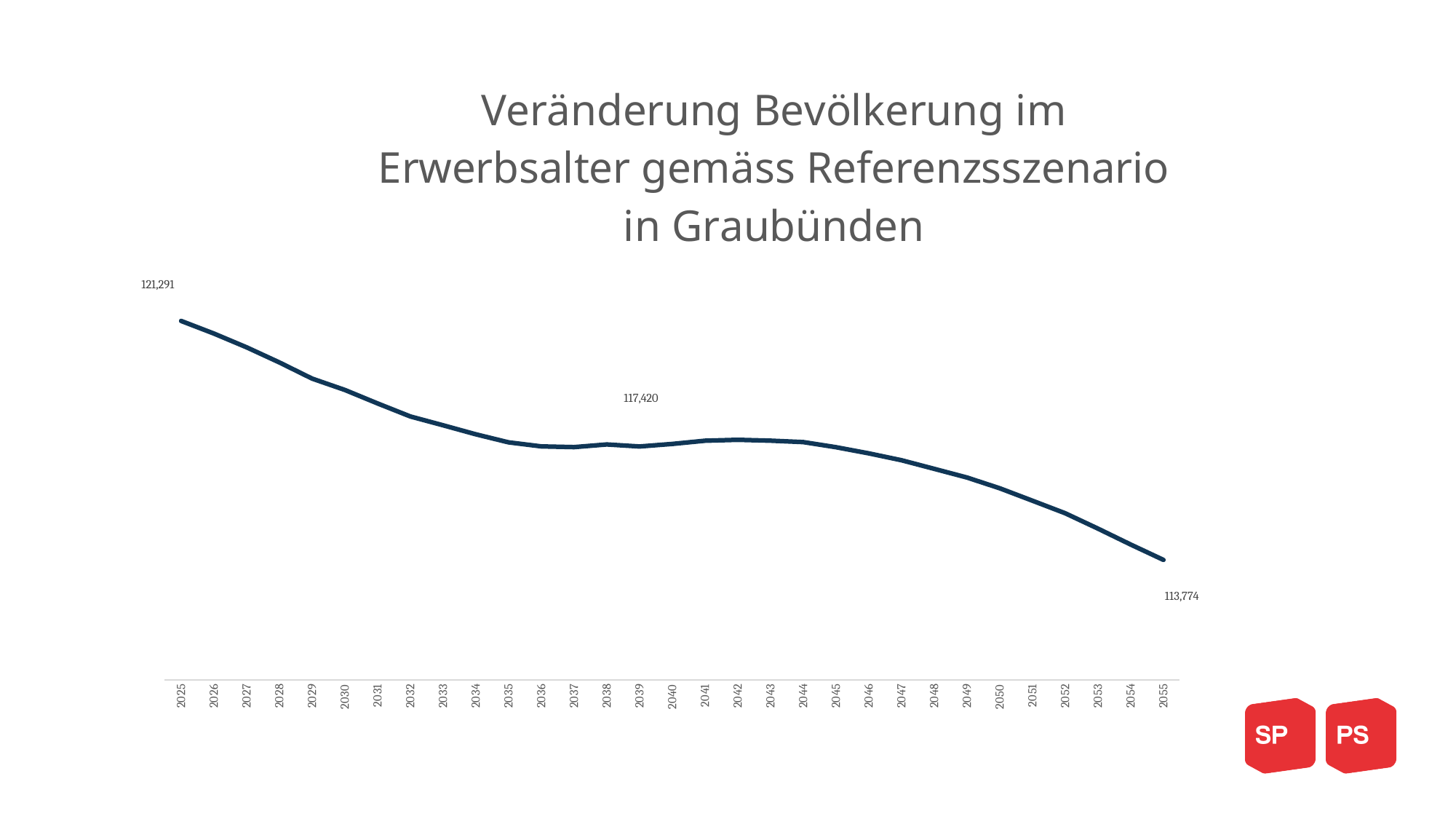
What is the difference between the values for 2025 and 2055? 7,517 How many years are shown on the x axis? 31 What kind of chart is this? Line chart What is the title of the chart? Veränderung Bevölkerung im Erwerbsalter gemäss Referenzsszenario in Graubünden Do the values rise or fall overall from 2025 to 2055? Fall Which year has the lowest value? 2055 What is the value for 2025? 121,291 What is the value for 2055? 113,774 Which year has the highest value? 2025 Which is larger, the value for 2039 or the value for 2055? 2039